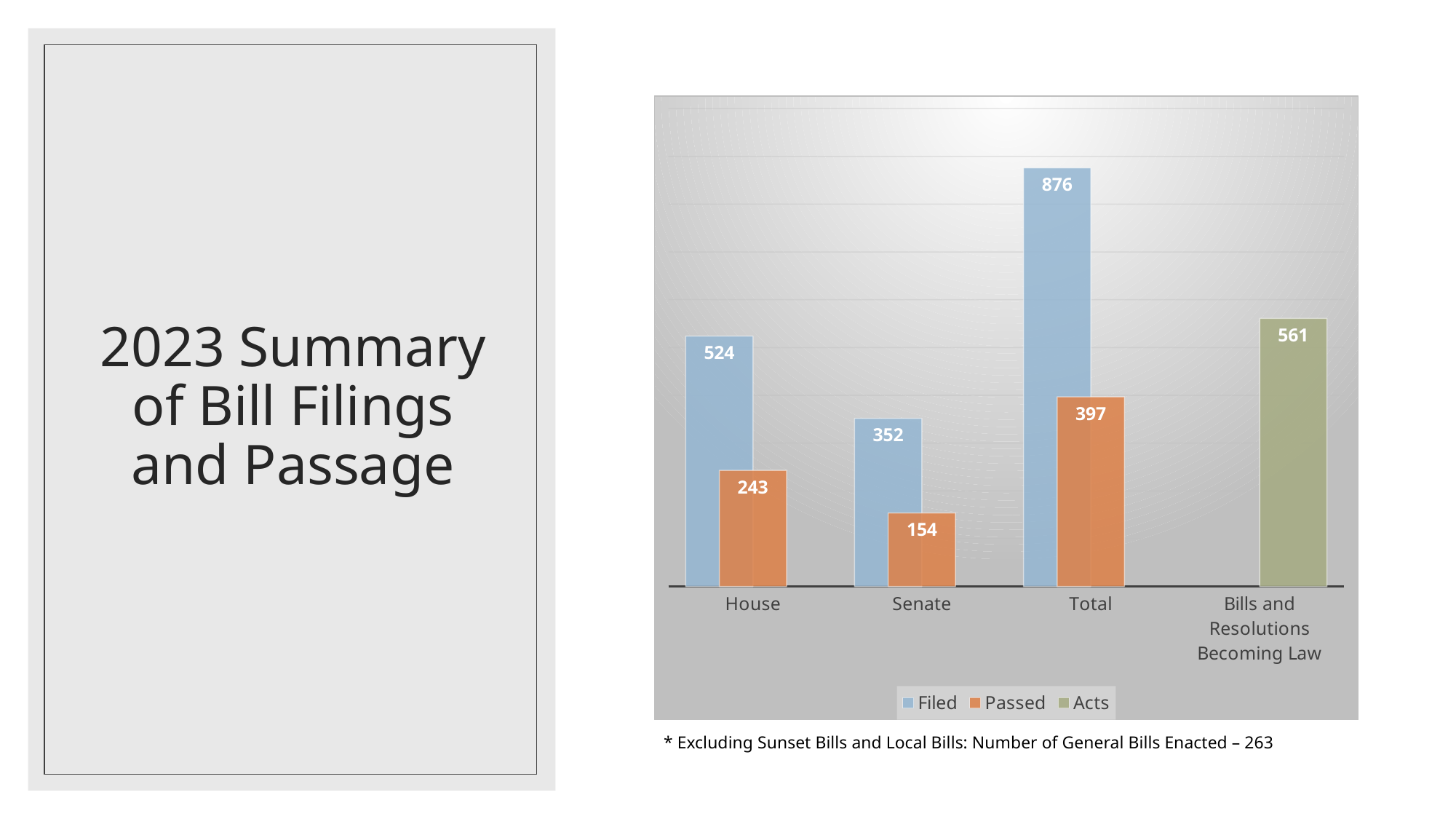
How many bills were Filed in the House? 524 What colour is the Passed series in the chart? Orange Which category has the lowest Passed value? Senate What is the difference between bills Filed and bills Passed in the House? 281 Which category has the highest Filed value? Total What is the difference between the Total Filed and Total Passed values? 479 How many bills were Passed in the Senate? 154 What is the Total number of bills Filed? 876 How many series does the legend list? 3 What kind of chart is shown on the slide? Bar chart What is the value of the Acts bar for Bills and Resolutions Becoming Law? 561 Which is larger: the Senate Filed value or the House Passed value? Senate Filed